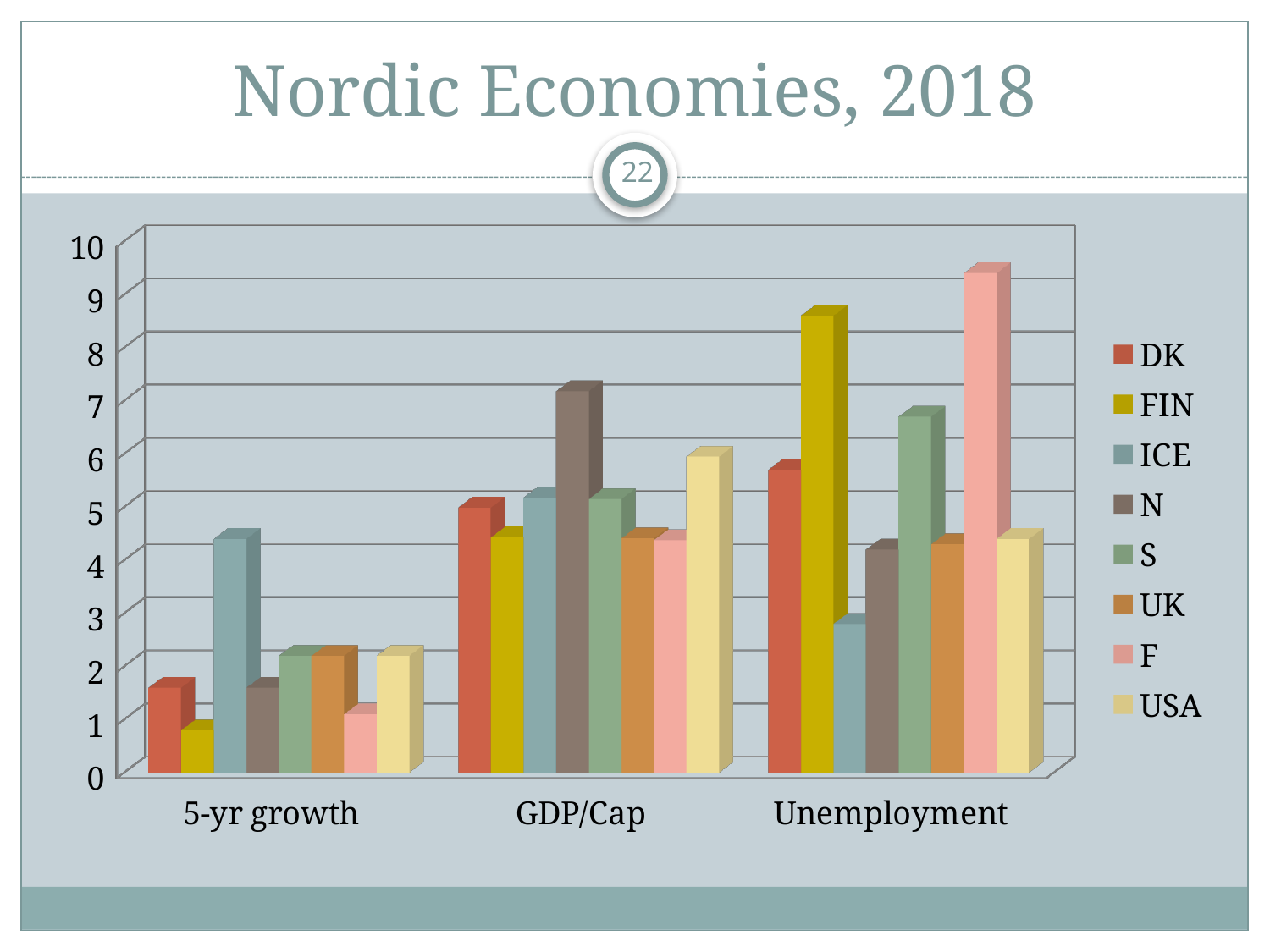
Is the Unemployment value for FIN greater or less than 8? greater Which country has the highest value for Unemployment? F Which country has the highest value for 5-yr growth? ICE What kind of chart is shown on the slide? bar chart Which country has the lowest value for Unemployment? ICE Which country has the lowest value for 5-yr growth? FIN What is the title of the slide containing the chart? Nordic Economies, 2018 Is the GDP/Cap value for N greater or less than 6? greater How many categories are shown on the x axis? 3 How many series does the legend list? 8 Which country has the highest value for GDP/Cap? N For Unemployment, which is larger, the value for S or the value for DK? S